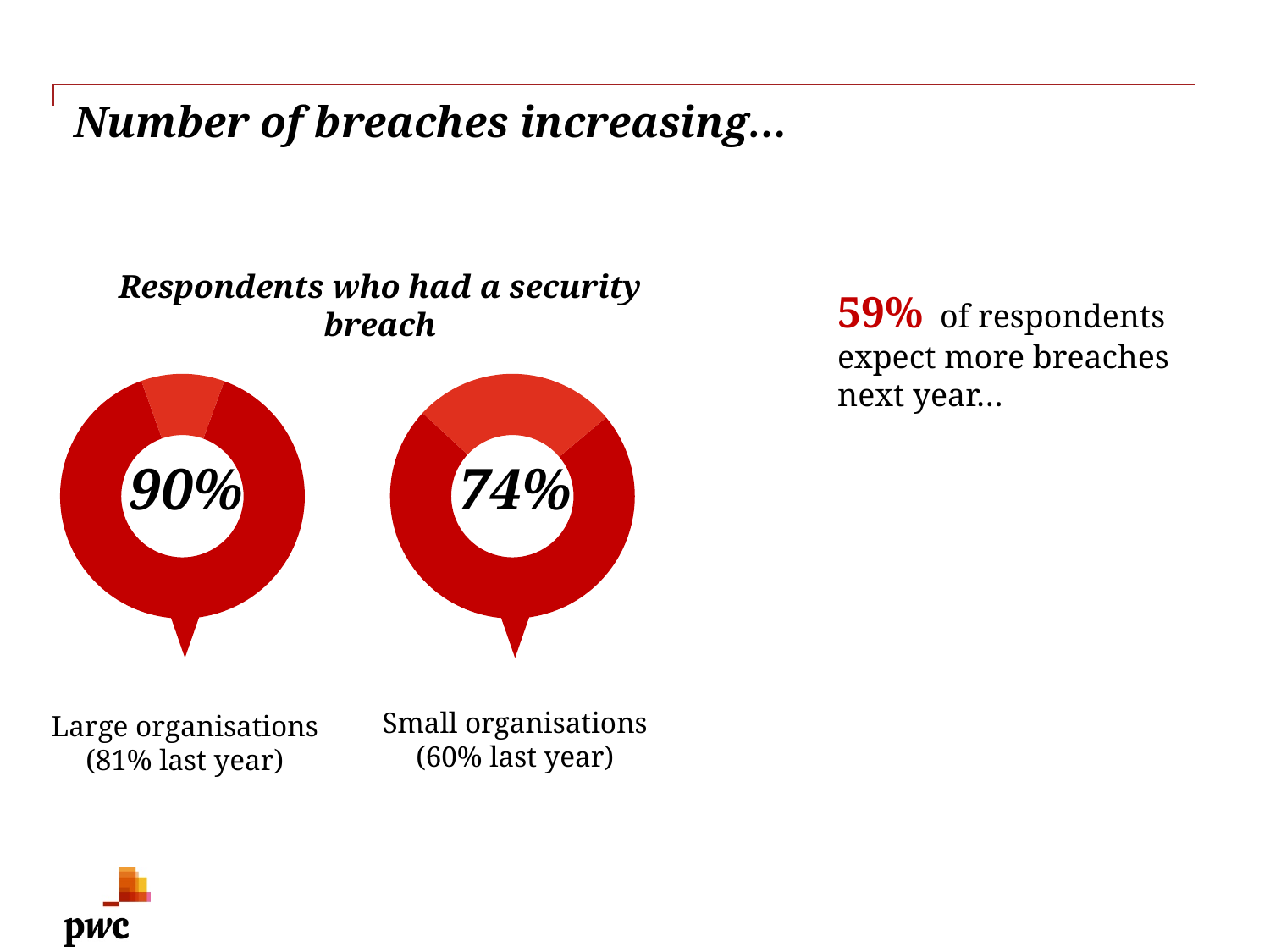
In the right donut chart, what share of the ring is not filled by the 74% segment? 26% What kind of chart is used to show the share of respondents who had a security breach? Donut chart What was last year's value for large organisations, as shown under the left donut chart? 81% What is the title shown above the two donut charts? Respondents who had a security breach In the left donut chart, what percentage of large organisations had a security breach? 90% What is the difference in percentage points between the large organisations value and the small organisations value in the donut charts? 16 percentage points Which group had the higher share of respondents with a security breach, large organisations or small organisations? Large organisations By how many percentage points did the small organisations value rise from last year (60%) to this year (74%)? 14 percentage points What was last year's value for small organisations, as shown under the right donut chart? 60% By how many percentage points did the large organisations value rise from last year (81%) to this year (90%)? 9 percentage points In the right donut chart, what percentage of small organisations had a security breach? 74% How many donut charts are shown on the slide? 2